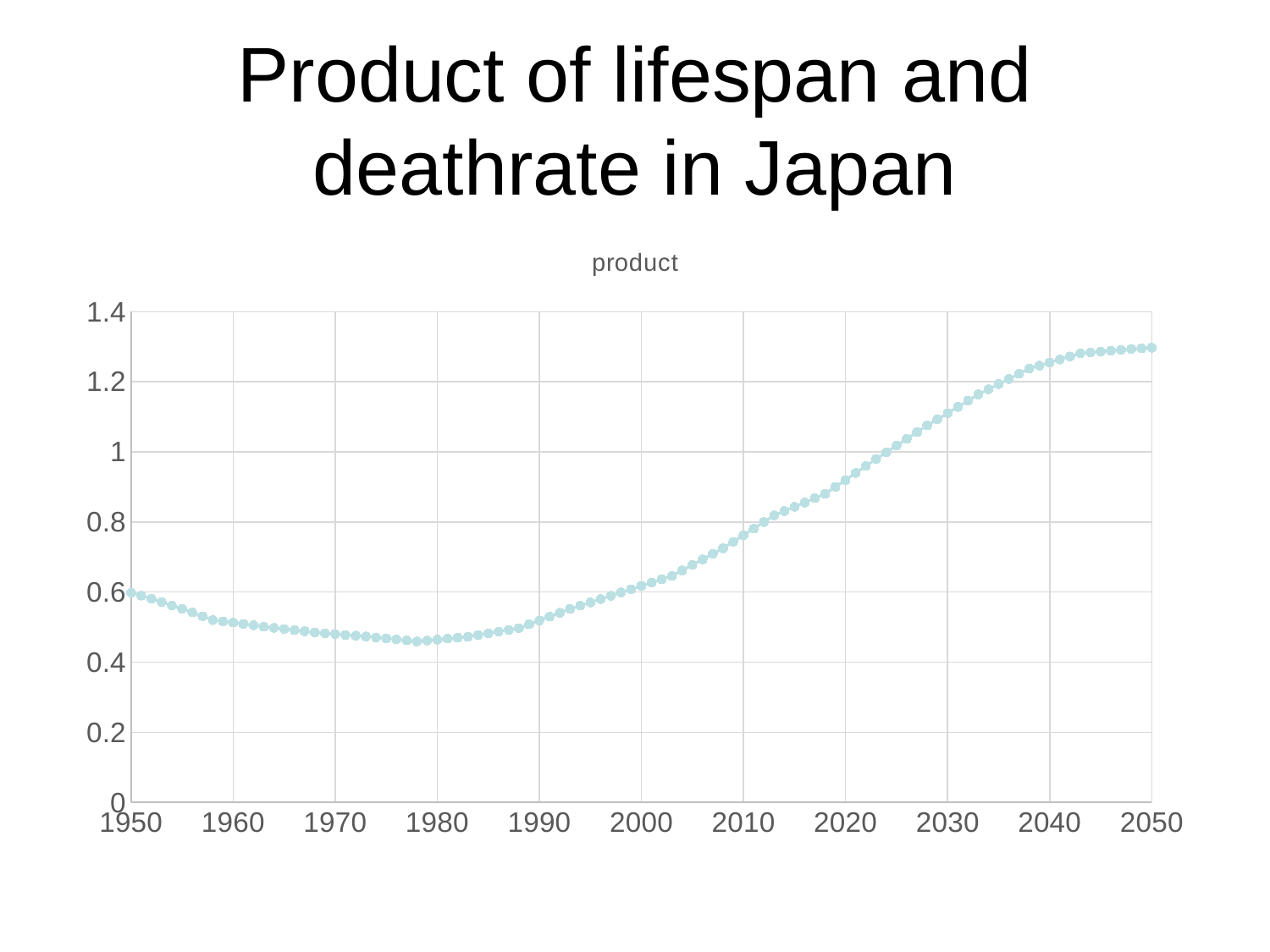
Is the value for 2030 greater or less than 1? greater Is the value for 1990 greater or less than 0.6? less Is the value for 1980 greater or less than 0.6? less In which decade does the series reach its lowest value? 1970s Do the values rise or fall between 2000 and 2050? rise What is the title printed above the plot area of the chart? product What kind of chart is shown on the slide? scatter chart What is the highest value shown on the y axis of the chart? 1.4 Which year has the highest value in the chart? 2050